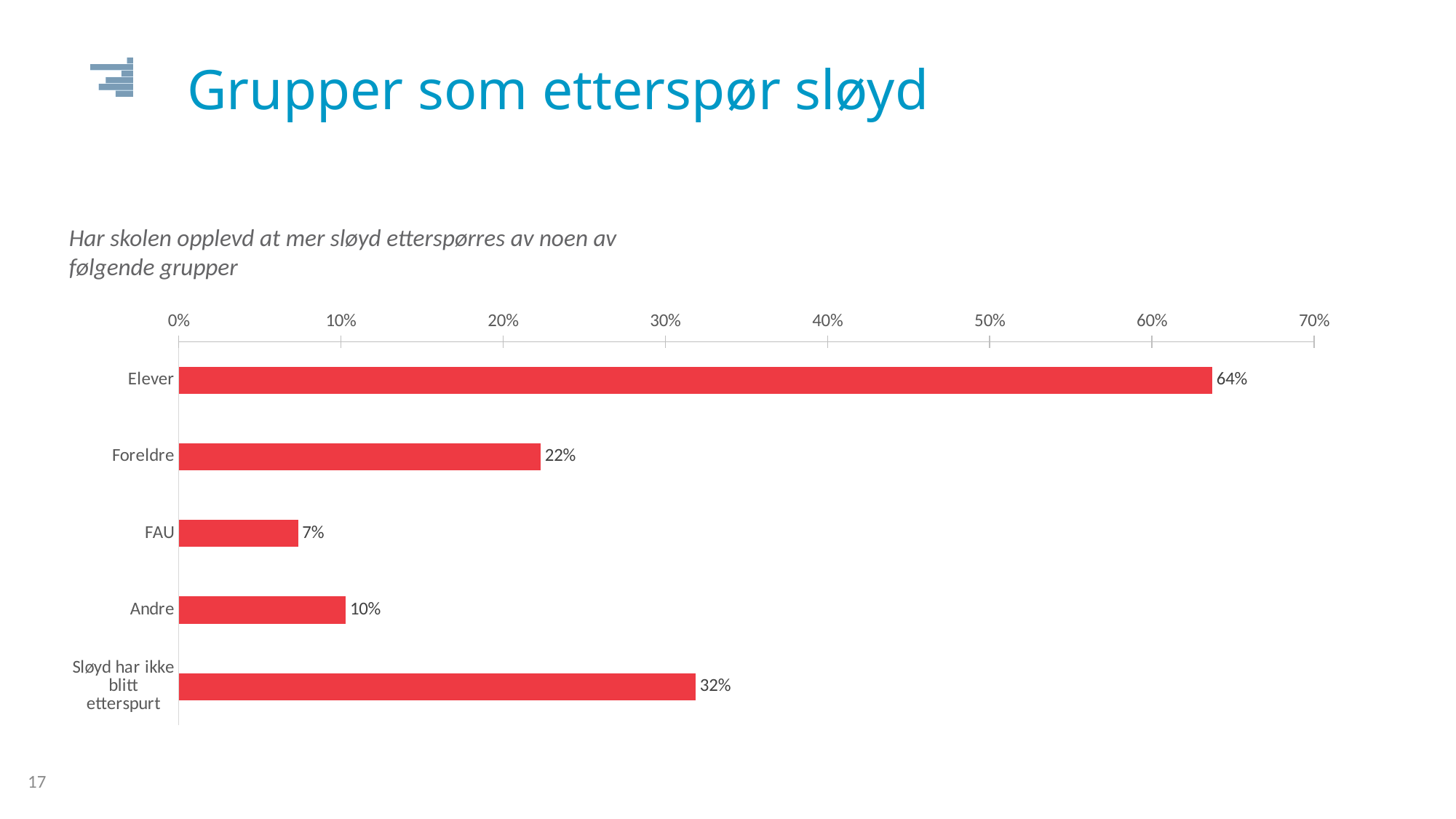
What is the value for FAU? 7% What is the difference between the values for Andre and FAU? 3% What kind of chart is shown on the slide? Bar chart What is the value for 'Sløyd har ikke blitt etterspurt'? 32% What is the value for Elever? 64% What is the value for Foreldre? 22% Which category has the lowest value? FAU Is the value for Elever greater or less than 60%? greater What is the difference between the values for Elever and Foreldre? 42% Which category has the highest value? Elever How many categories are shown in the chart? 5 Which is larger, the value for Foreldre or the value for 'Sløyd har ikke blitt etterspurt'? Sløyd har ikke blitt etterspurt